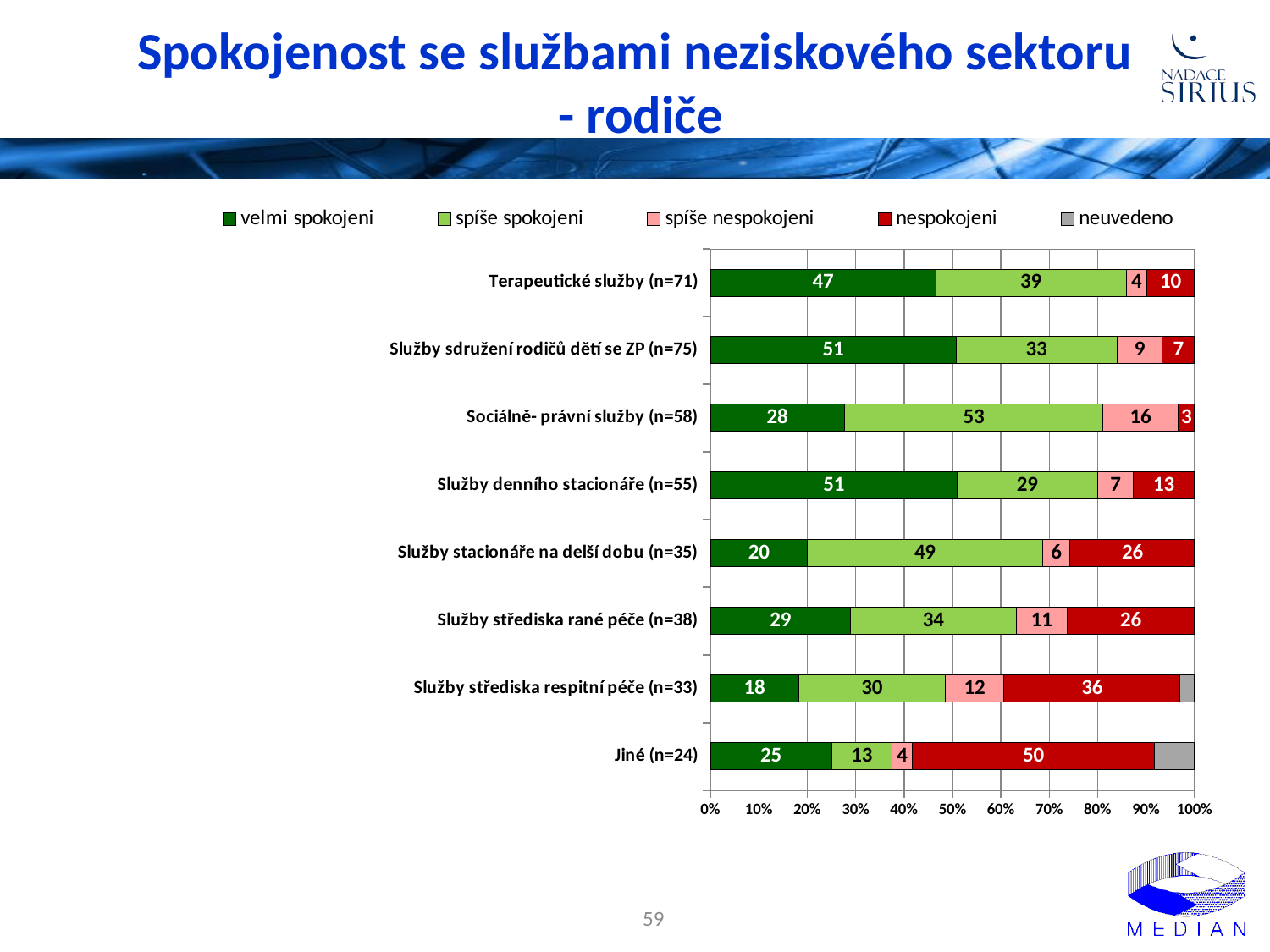
What is the "nespokojeni" value for Služby střediska respitní péče (n=33)? 36 What percentage of parents were "velmi spokojeni" with Terapeutické služby (n=71)? 47 How many service categories are shown in the chart? 8 What is the difference between the "velmi spokojeni" values for Služby denního stacionáře (n=55) and Služby stacionáře na delší dobu (n=35)? 31 Which category has the lowest "velmi spokojeni" value? Služby střediska respitní péče (n=33) Which is larger: the "spíše spokojeni" value for Terapeutické služby (n=71) or for Služby střediska rané péče (n=38)? Terapeutické služby (n=71) What is the "spíše spokojeni" value for Sociálně- právní služby (n=58)? 53 How many series does the legend list? 5 What colour represents "nespokojeni" in the chart? Red Which category has the highest "nespokojeni" value? Jiné (n=24) What is the "spíše nespokojeni" value for Služby sdružení rodičů dětí se ZP (n=75)? 9 What kind of chart is shown on the slide? Stacked bar chart